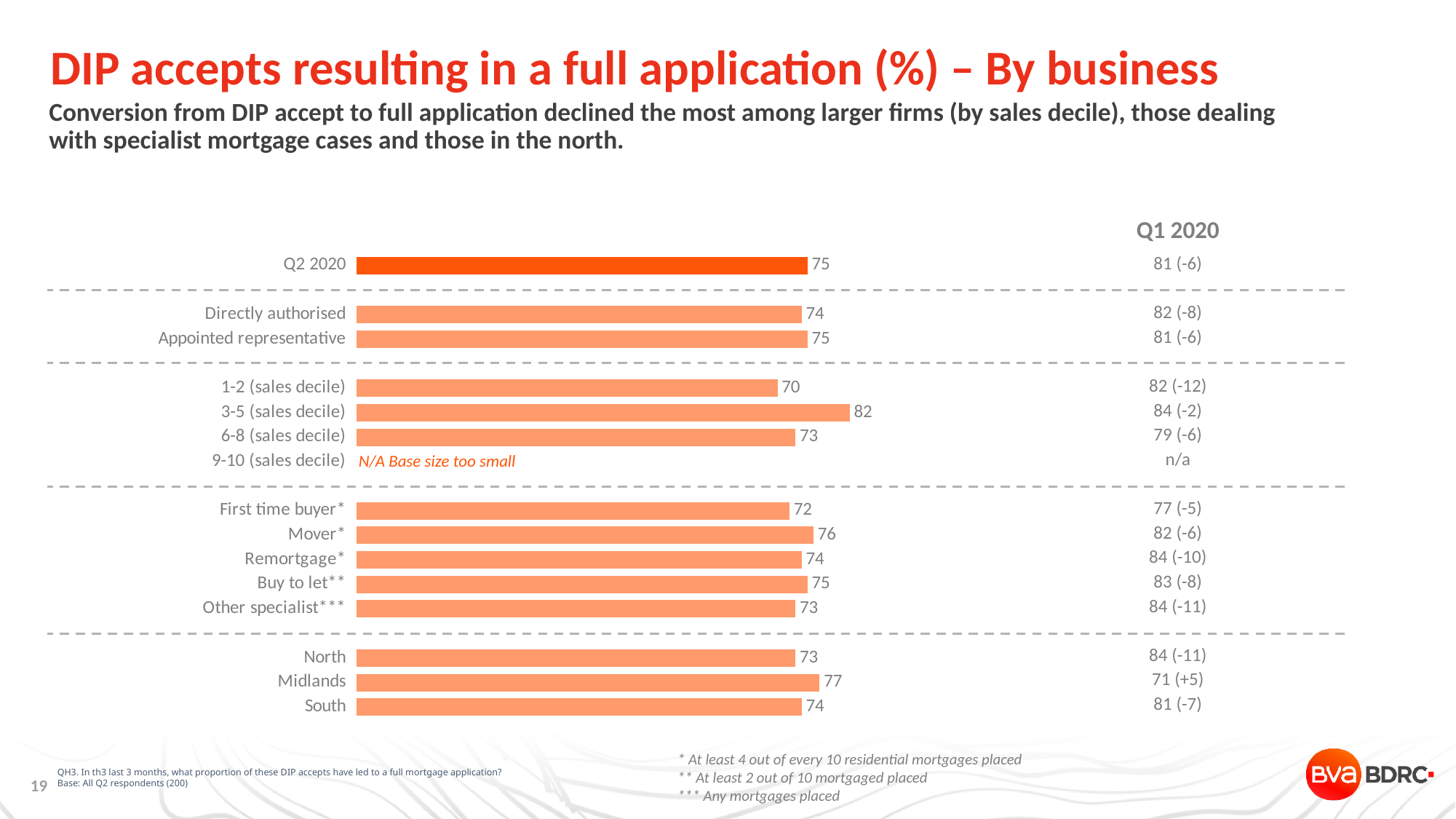
What is the value for Q2 2020 overall? 75 What is the difference between the values for Midlands and North? 4 What is the difference between the values for 3-5 (sales decile) and 1-2 (sales decile)? 12 Which category has the highest value? 3-5 (sales decile) How many categories have a bar plotted on the chart? 14 What is shown for 9-10 (sales decile) instead of a bar? N/A Base size too small What kind of chart is shown on the slide? Bar chart What is the value for Other specialist? 73 What is the value for Midlands? 77 Which category has the lowest value? 1-2 (sales decile) What is the value for 1-2 (sales decile)? 70 Which is larger, the value for Mover or the value for First time buyer? Mover